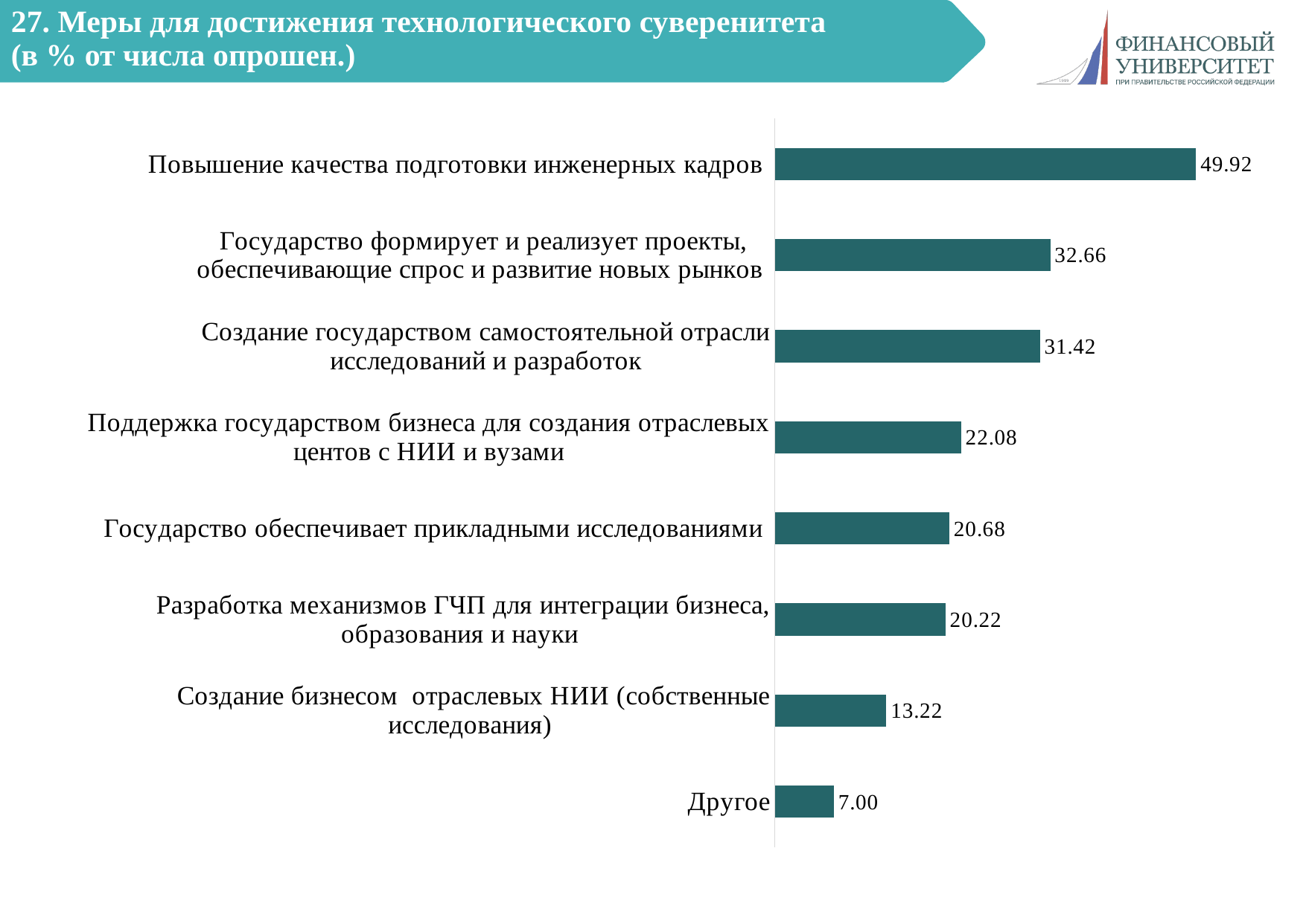
Which category has the lowest value? Другое Which category has the highest value? Повышение качества подготовки инженерных кадров Which is larger: the value for «Поддержка государством бизнеса для создания отраслевых центов с НИИ и вузами» or for «Создание бизнесом отраслевых НИИ (собственные исследования)»? Поддержка государством бизнеса для создания отраслевых центов с НИИ и вузами What is the title of the slide? 27. Меры для достижения технологического суверенитета (в % от числа опрошен.) What kind of chart is shown on the slide? Bar chart How many categories are shown in the chart? 8 What is the difference between the values for «Повышение качества подготовки инженерных кадров» and «Другое»? 42.92 What is the difference between the values for «Государство формирует и реализует проекты, обеспечивающие спрос и развитие новых рынков» and «Создание государством самостоятельной отрасли исследований и разработок»? 1.24 What is the value for «Другое»? 7.00 What is the value for «Государство обеспечивает прикладными исследованиями»? 20.68 What is the value for «Создание бизнесом отраслевых НИИ (собственные исследования)»? 13.22 What is the value for «Повышение качества подготовки инженерных кадров»? 49.92